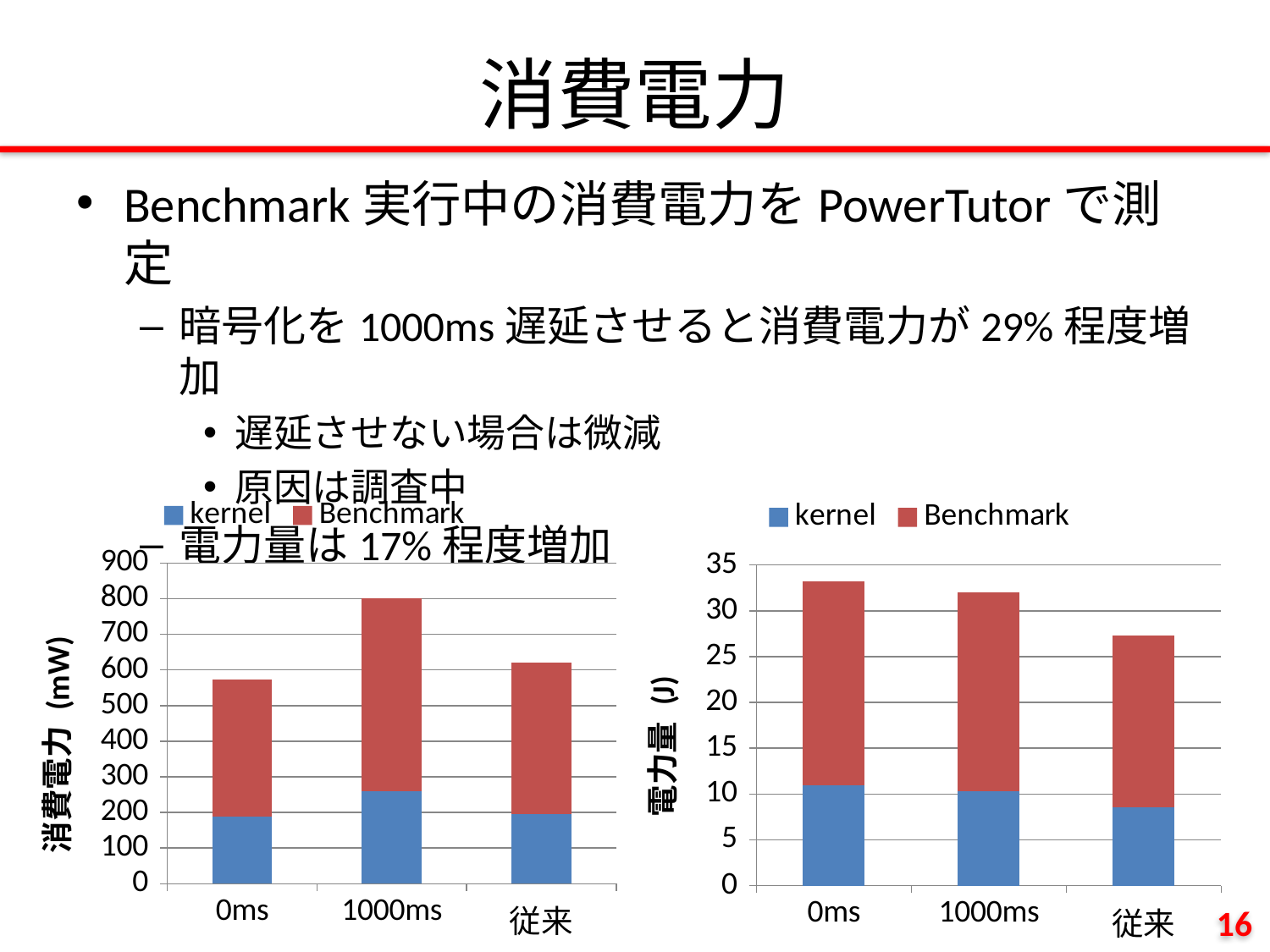
In the left chart (消費電力 (mW)), which category has the highest total bar? 1000ms How many series does the legend of the right chart (電力量 (J)) list? 2 What are the two legend entries of the left chart (消費電力 (mW))? kernel, Benchmark In the right chart (電力量 (J)), is the kernel value for 0ms greater or less than 10? greater How many categories are shown on the x axis of the left chart (消費電力 (mW))? 3 In the left chart (消費電力 (mW)), is the total for 0ms greater or less than 600? less What kind of chart is the left chart (消費電力 (mW))? stacked bar chart In the right chart (電力量 (J)), which category has the lowest total bar? 従来 In the right chart (電力量 (J)), is the total for 従来 greater or less than 30? less In the left chart (消費電力 (mW)), which is larger, the total for 従来 or the total for 0ms? 従来 In the right chart (電力量 (J)), do the total bars rise or fall from 1000ms to 従来? fall